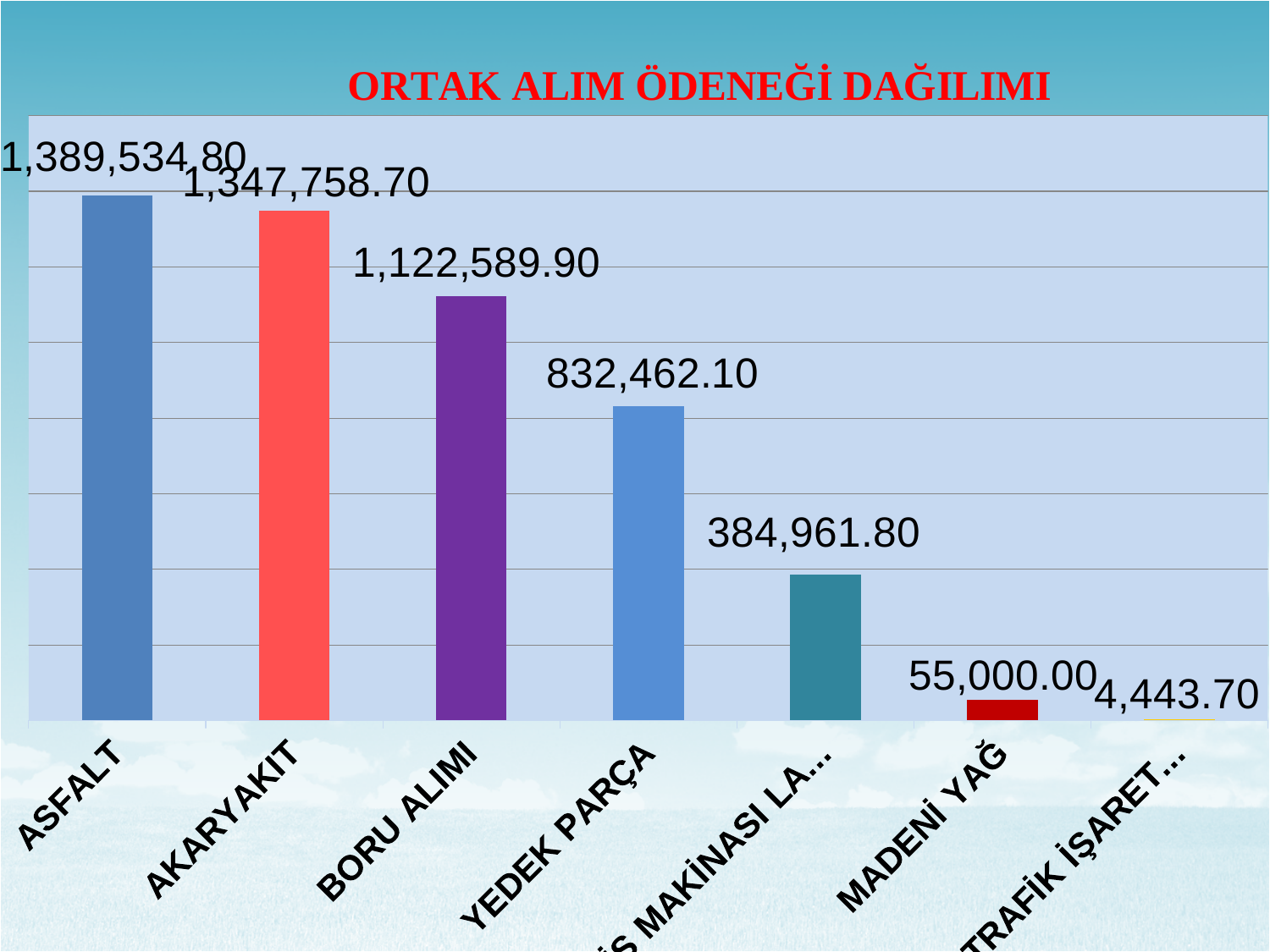
Which is larger, the value for BORU ALIMI or the value for YEDEK PARÇA? BORU ALIMI What is the value for MADENİ YAĞ? 55,000.00 Do the values rise or fall from left to right along the x axis? fall What is the value for AKARYAKIT? 1,347,758.70 What is the difference between the values for ASFALT and AKARYAKIT? 41,776.10 Which category has the lowest value? TRAFİK İŞARET… (the rightmost bar) Which category has the highest value? ASFALT How many bars are shown in the chart? 7 What is the value for BORU ALIMI? 1,122,589.90 What is the value shown for the rightmost bar (TRAFİK İŞARET…)? 4,443.70 What is the value for ASFALT? 1,389,534.80 What is the value for YEDEK PARÇA? 832,462.10